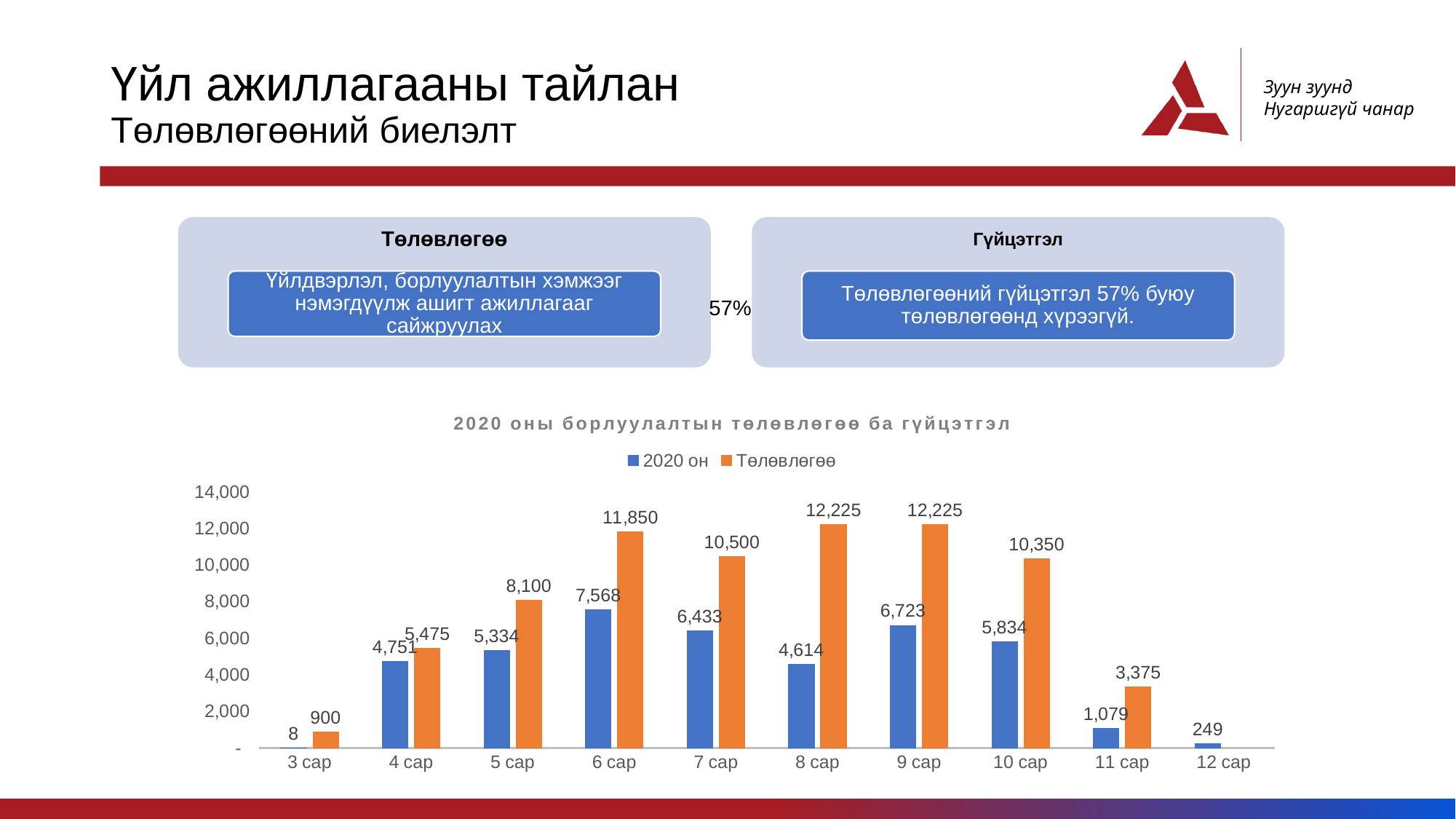
In which month is the 2020 он series lowest? 3 сар What type of chart is shown on the slide? Bar chart What is the value of the Төлөвлөгөө series for 8 сар? 12,225 What is the value of the 2020 он series for 12 сар? 249 How many month categories are shown on the x axis of the chart? 10 What is the title of the chart? 2020 оны борлуулалтын төлөвлөгөө ба гүйцэтгэл Which is larger for 9 сар: the 2020 он value or the Төлөвлөгөө value? Төлөвлөгөө How many series does the chart legend list? 2 What is the difference between the Төлөвлөгөө value and the 2020 он value for 8 сар? 7,611 What is the value of the 2020 он series for 6 сар? 7,568 Is the Төлөвлөгөө value for 10 сар greater or less than 10,000? greater In which month is the 2020 он series highest? 6 сар